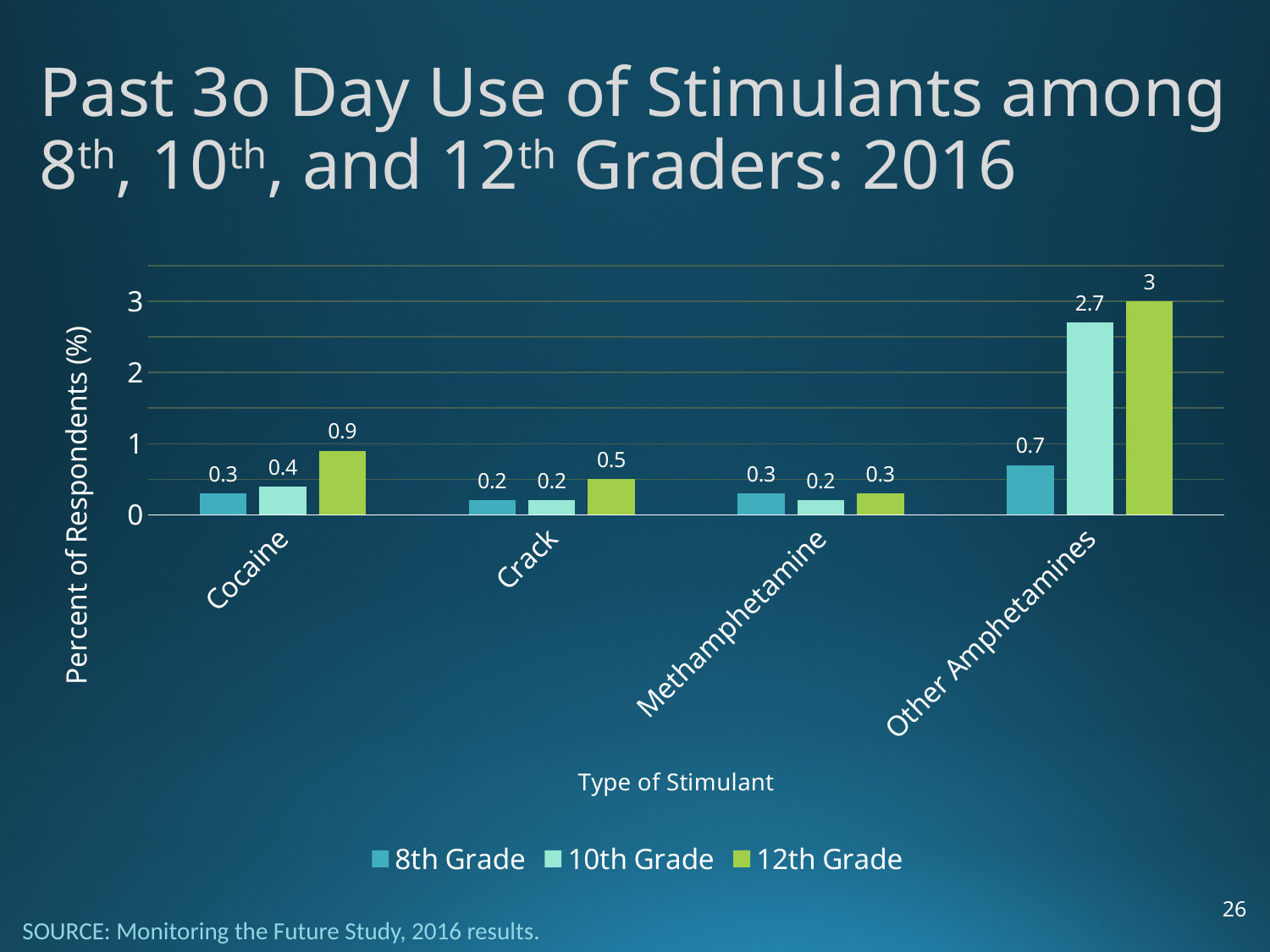
Which type of stimulant has the highest value for 12th Grade? Other Amphetamines What is the value for 12th Grade for Crack? 0.5 What is the value for 12th Grade for Other Amphetamines? 3 Which is larger, the 12th Grade value for Cocaine or the 12th Grade value for Crack? Cocaine Is the value for 10th Grade for Other Amphetamines greater or less than 2? greater What kind of chart is shown on the slide? Bar chart How many series does the legend list? 3 What is the value for 10th Grade for Other Amphetamines? 2.7 Which type of stimulant has the lowest value for 8th Grade? Crack What is the difference between the 12th Grade and 8th Grade values for Other Amphetamines? 2.3 How many types of stimulant are shown on the x axis? 4 What is the value for 8th Grade for Cocaine? 0.3